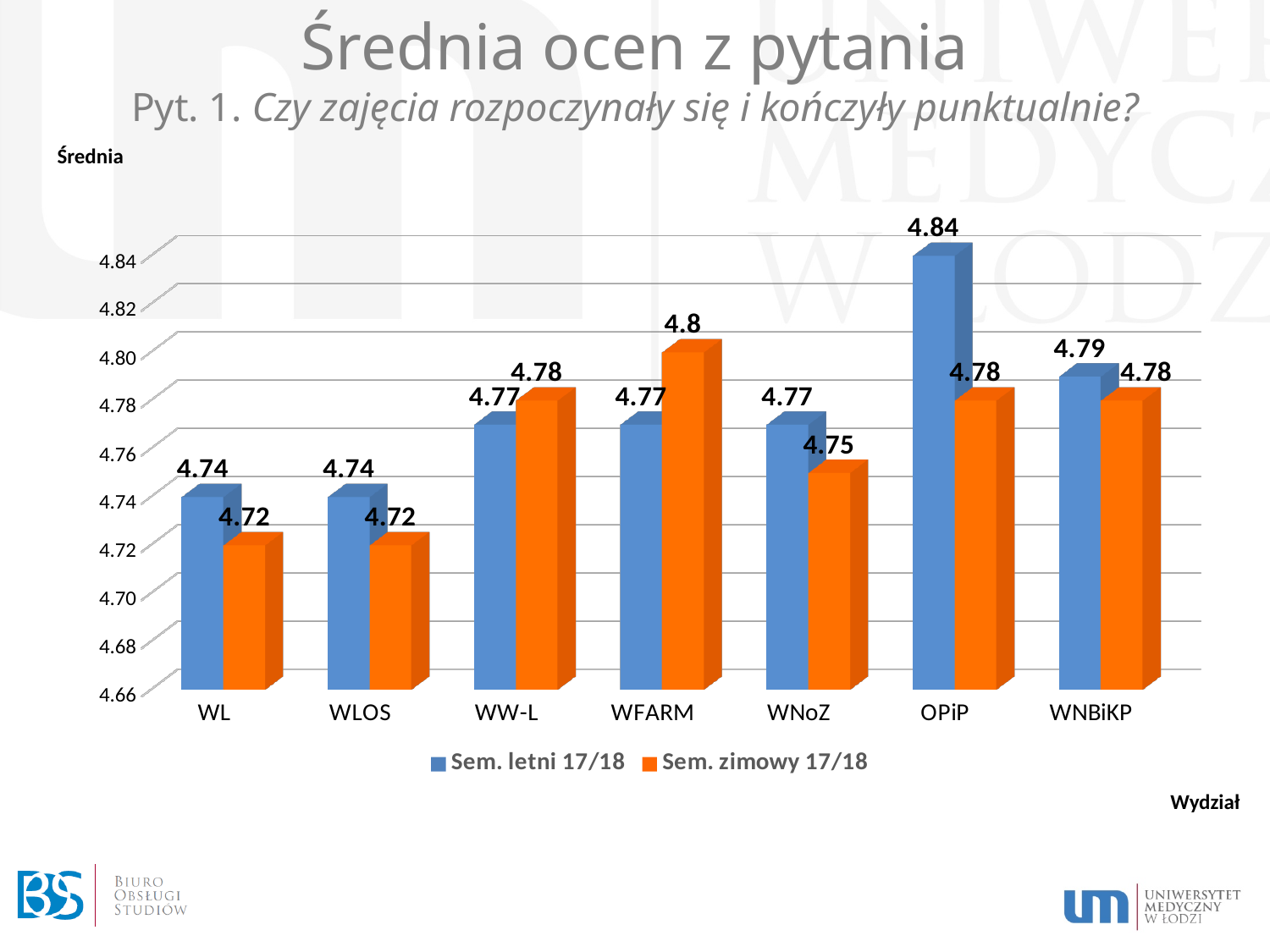
What kind of chart is shown on the slide? Bar chart What is the difference between the Sem. letni 17/18 and Sem. zimowy 17/18 values for OPiP? 0.06 How many series does the legend list? 2 Which is larger for WNoZ: the Sem. letni 17/18 value or the Sem. zimowy 17/18 value? Sem. letni 17/18 What is the value for WFARM in the Sem. zimowy 17/18 series? 4.8 Which category has the highest value in the Sem. letni 17/18 series? OPiP Which category has the highest value in the Sem. zimowy 17/18 series? WFARM What is the value for WL in the Sem. zimowy 17/18 series? 4.72 How many categories (faculties) are shown on the x axis? 7 Which is larger for WFARM: the Sem. letni 17/18 value or the Sem. zimowy 17/18 value? Sem. zimowy 17/18 What is the value for WNoZ in the Sem. zimowy 17/18 series? 4.75 What is the value for OPiP in the Sem. letni 17/18 series? 4.84